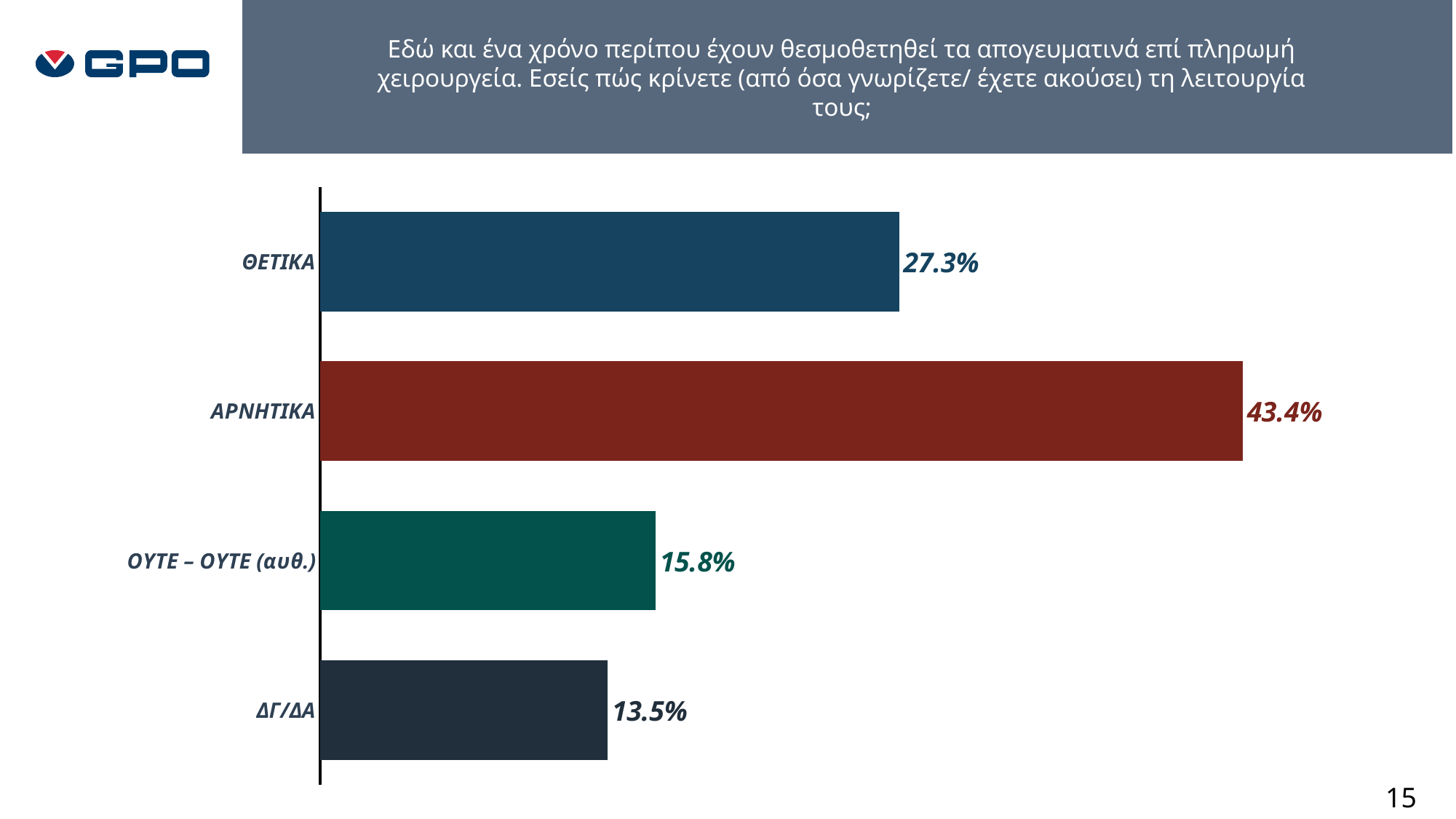
How many categories are shown in the chart? 4 Which is larger, the value for ΘΕΤΙΚΑ or the value for ΑΡΝΗΤΙΚΑ? ΑΡΝΗΤΙΚΑ Which category has the highest value? ΑΡΝΗΤΙΚΑ What kind of chart is shown on the slide? Bar chart What is the value for ΘΕΤΙΚΑ? 27.3% What is the value for ΟΥΤΕ – ΟΥΤΕ (αυθ.)? 15.8% What colour is the bar for ΑΡΝΗΤΙΚΑ? Dark red What is the value for ΔΓ/ΔΑ? 13.5% What is the value for ΑΡΝΗΤΙΚΑ? 43.4% Which category has the lowest value? ΔΓ/ΔΑ What is the difference between the values for ΑΡΝΗΤΙΚΑ and ΘΕΤΙΚΑ? 16.1% What is the difference between the values for ΟΥΤΕ – ΟΥΤΕ (αυθ.) and ΔΓ/ΔΑ? 2.3%